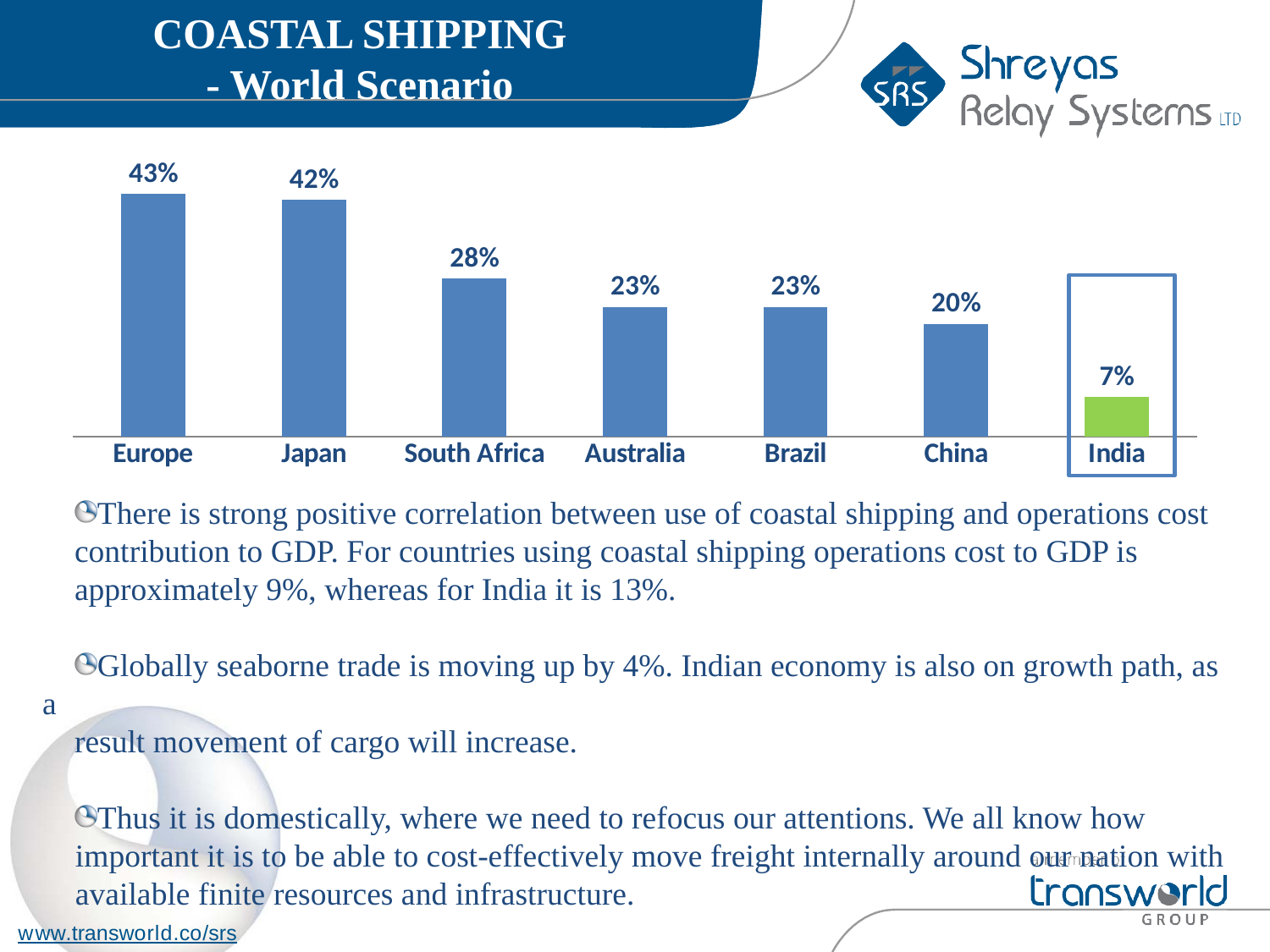
What kind of chart is shown on the slide? Bar chart What is the value shown for China? 20% What is the value shown for India? 7% Which country's bar is shown in a different colour (green) from the others? India Which country has the highest value in the chart? Europe What is the difference between the values for Europe and India? 36% How many countries are shown in the chart? 7 Which has a larger value, South Africa or China? South Africa What is the difference between the values for Japan and South Africa? 14% What is the value shown for South Africa? 28% Which country has the lowest value in the chart? India What is the value shown for Europe? 43%